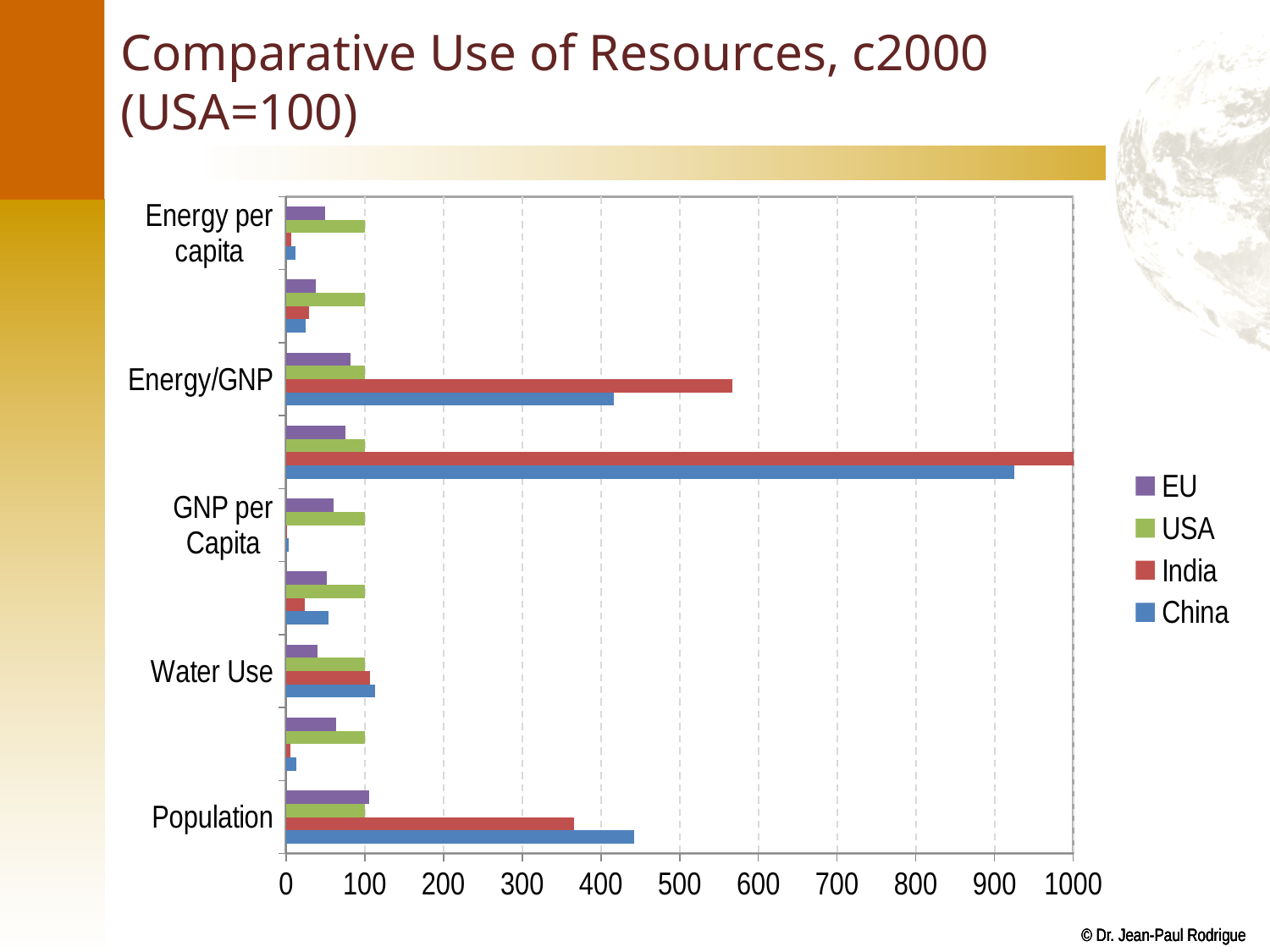
Which series has the highest value in the Population category? China What kind of chart is shown on the slide? bar chart What is the value for USA in the Energy/GNP category? 100 In the Population category, which is larger, the value for China or the value for India? China Which series has the highest value in the Energy per capita category? USA Which series has the highest value in the Energy/GNP category? India Is the value for India in the Energy/GNP category greater or less than 500? greater What is the title of the chart on the slide? Comparative Use of Resources, c2000 (USA=100) What is the value for USA in the Population category? 100 Is the value for China in the Population category greater or less than 400? greater How many series does the legend list? 4 Is the value for EU in the Energy per capita category greater or less than 100? less